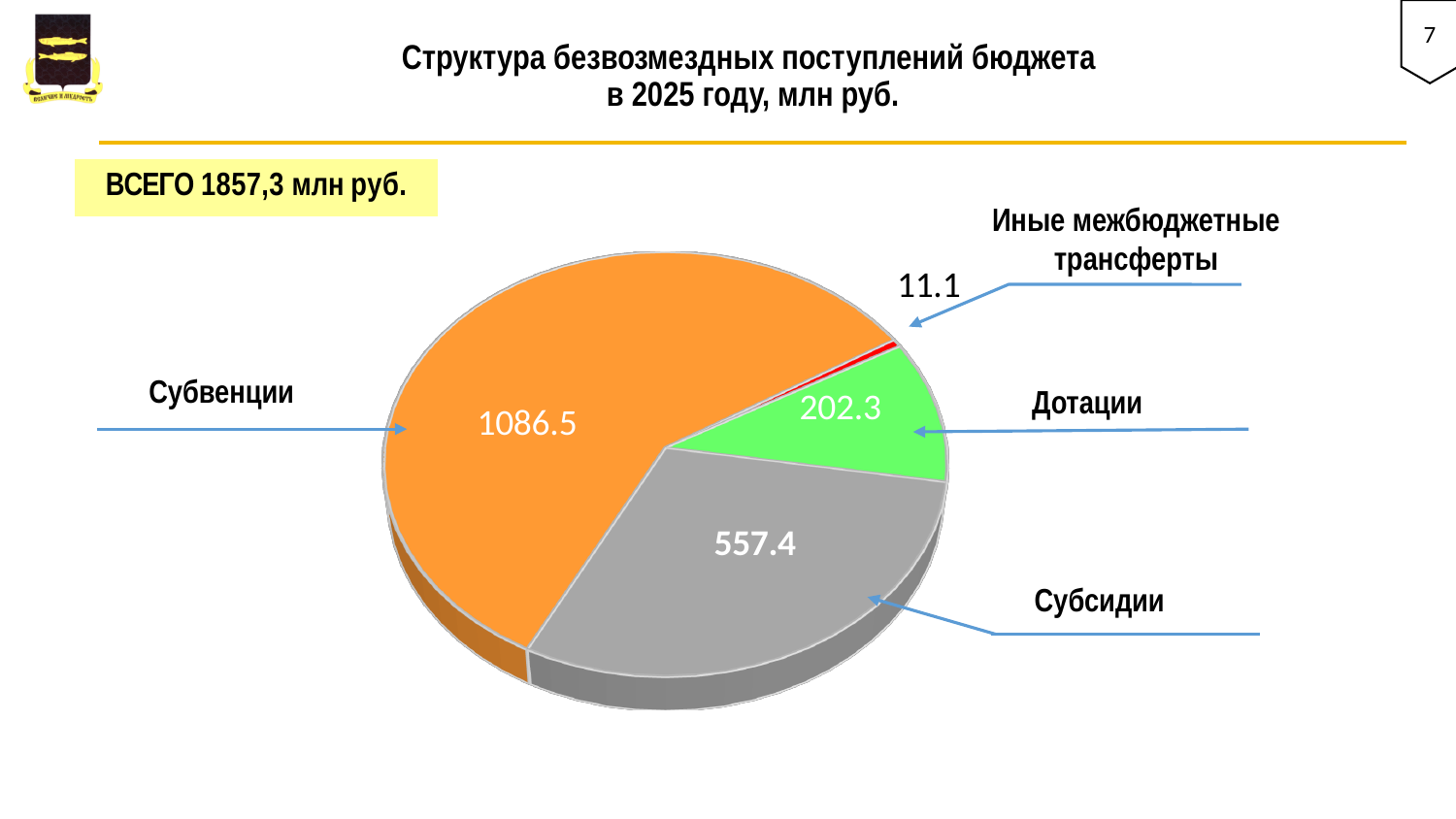
Which is larger, the value for Дотации or the value for Субсидии? Субсидии What is the value for Субсидии in the pie chart? 557.4 What is the difference between the values for Субвенции and Субсидии? 529.1 What kind of chart is shown on the slide? Pie chart What total amount is stated on the slide for all the categories in the chart? 1857,3 млн руб. How many categories are shown in the pie chart? 4 Which category has the smallest slice of the pie chart? Иные межбюджетные трансферты What is the value for Дотации in the pie chart? 202.3 What is the difference between the values for Субсидии and Дотации? 355.1 What is the value for Иные межбюджетные трансферты in the pie chart? 11.1 What is the value for Субвенции in the pie chart? 1086.5 Which category has the largest slice of the pie chart? Субвенции